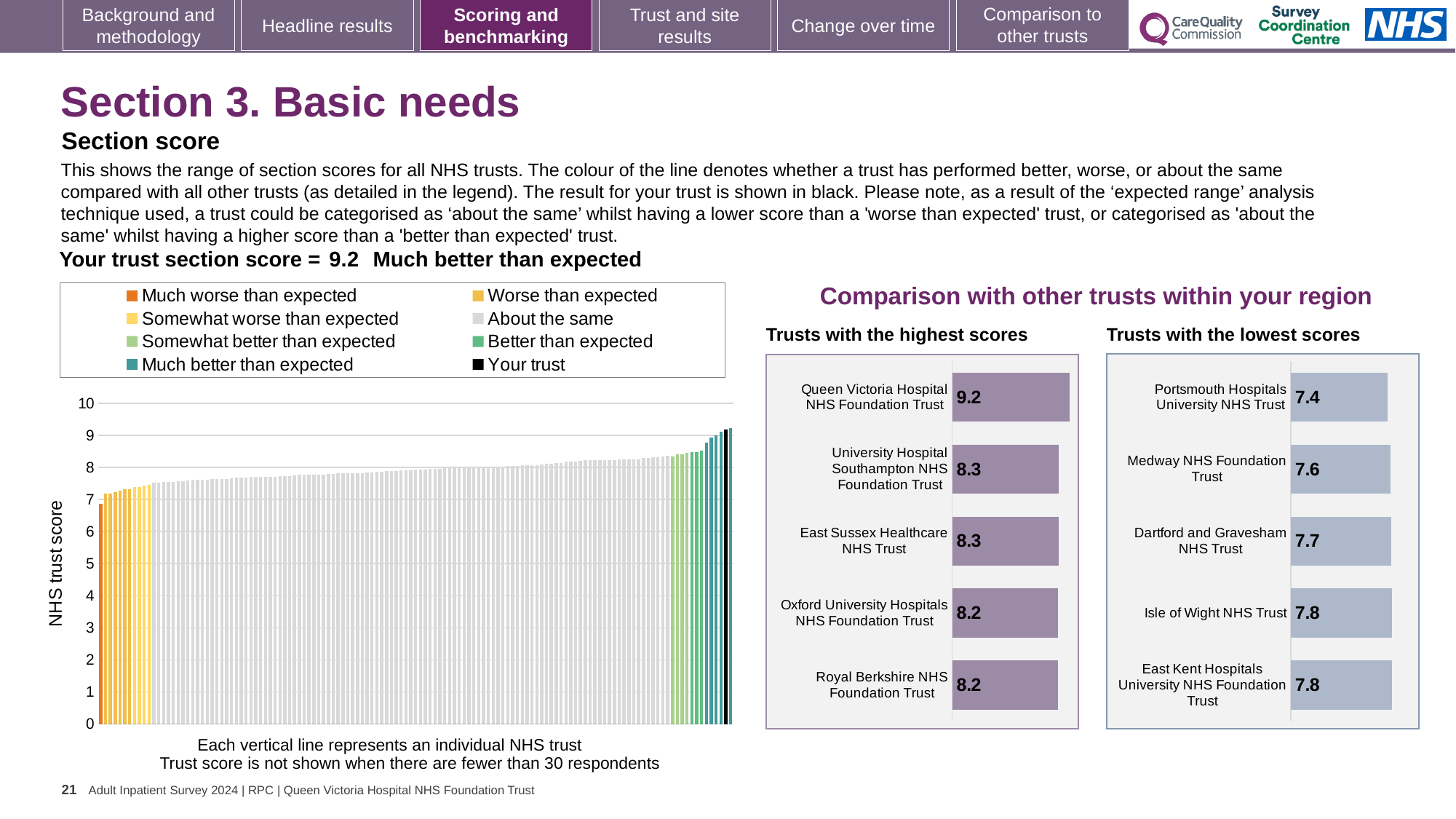
How many entries does the legend of the left-hand chart of all NHS trusts list? 8 How many trusts are shown in the 'Trusts with the highest scores' chart? 5 What is the y-axis label of the left-hand chart of all NHS trusts? NHS trust score In the 'Trusts with the highest scores' chart, what is the difference between the scores of Queen Victoria Hospital NHS Foundation Trust and Royal Berkshire NHS Foundation Trust? 1.0 In the 'Trusts with the lowest scores' chart, what is the score for Portsmouth Hospitals University NHS Trust? 7.4 In the 'Trusts with the highest scores' chart, what is the score for Queen Victoria Hospital NHS Foundation Trust? 9.2 In the 'Trusts with the lowest scores' chart, which has the larger score: Medway NHS Foundation Trust or Isle of Wight NHS Trust? Isle of Wight NHS Trust In the 'Trusts with the lowest scores' chart, what is the score for Dartford and Gravesham NHS Trust? 7.7 In the 'Trusts with the lowest scores' chart, which trust has the lowest score? Portsmouth Hospitals University NHS Trust In the left-hand chart of all NHS trusts, do the scores rise or fall from left to right? Rise In the 'Trusts with the highest scores' chart, which trust has the highest score? Queen Victoria Hospital NHS Foundation Trust What kind of chart is the left-hand chart showing the range of section scores for all NHS trusts? Bar chart